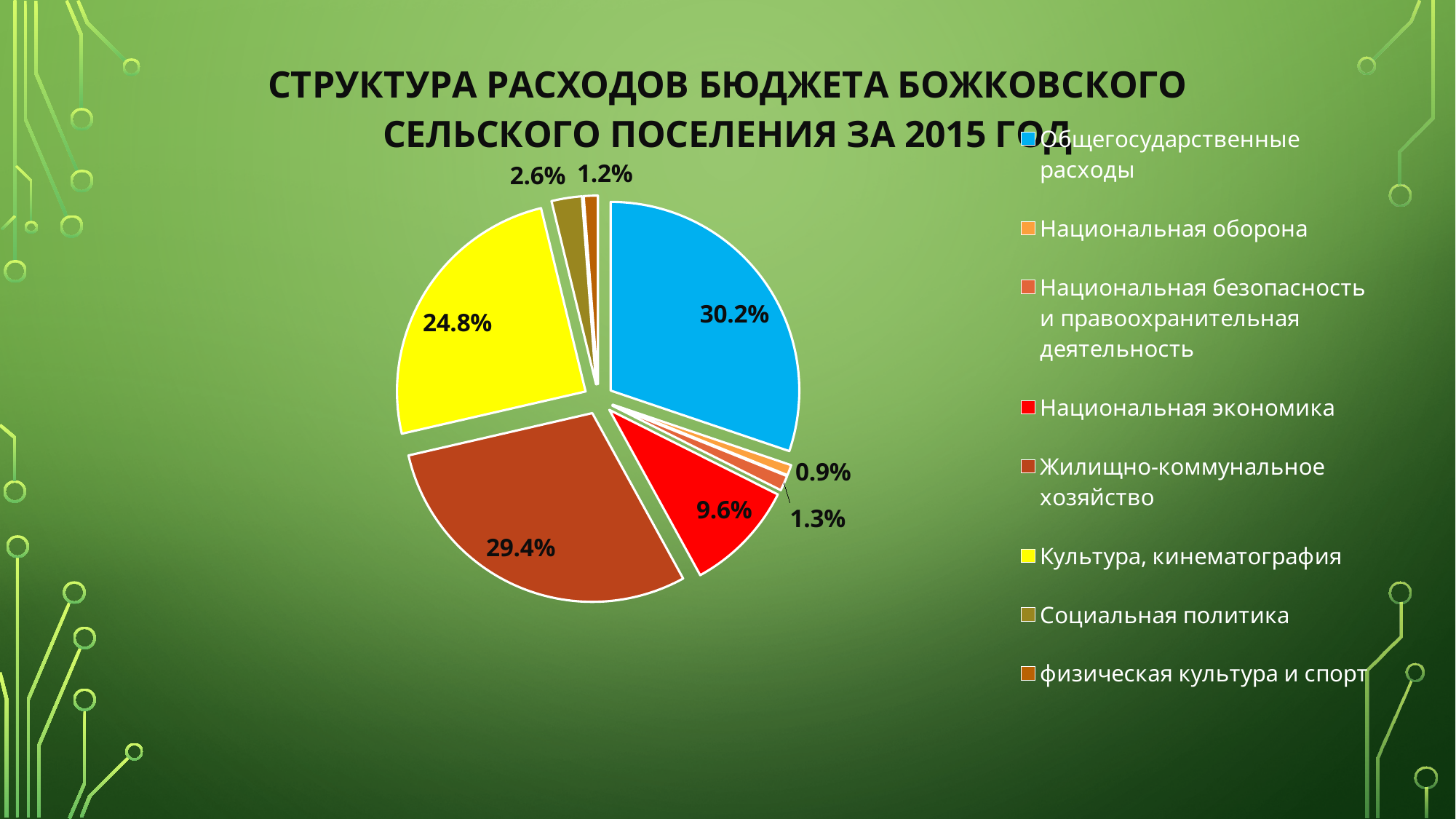
How many expenditure categories are shown in the pie chart? 8 What share of the budget expenditure goes to Культура, кинематография? 24.8% Which expenditure category has the smallest share of the budget? Национальная оборона Which expenditure category has the largest share of the budget? Общегосударственные расходы What is the difference in percentage points between Общегосударственные расходы and Жилищно-коммунальное хозяйство? 0.8 What share of the budget expenditure goes to Общегосударственные расходы? 30.2% What share of the budget expenditure goes to Национальная экономика? 9.6% What kind of chart is shown on the slide? Pie chart What share of the budget expenditure goes to Жилищно-коммунальное хозяйство? 29.4% What share of the budget expenditure goes to Социальная политика? 2.6% Which colour represents Национальная экономика in the pie chart? Red Which is larger: the share for Культура, кинематография or the share for Национальная экономика? Культура, кинематография